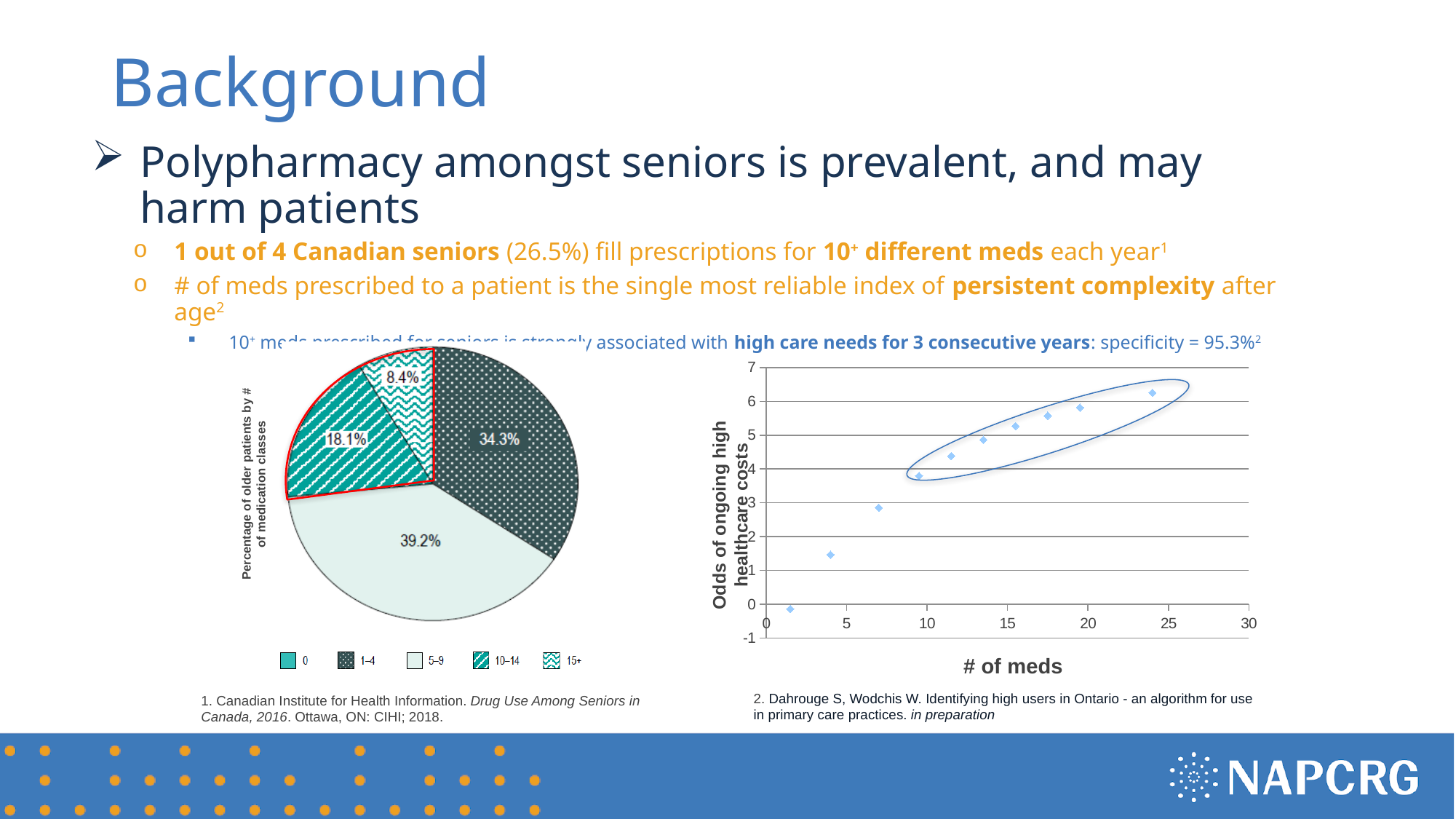
On the pie chart on the left, what is the difference in percentage points between the 5–9 and 1–4 categories? 4.9 percentage points On the scatter chart on the right, is the odds value for the point at about 4 meds greater or less than 2? less On the pie chart on the left, what percentage of older patients take 1–4 medication classes? 34.3% What kind of chart is shown on the right side of the slide? Scatter chart On the pie chart on the left, what is the combined share of the 10–14 and 15+ categories? 26.5% On the scatter chart on the right, do the odds of ongoing high healthcare costs rise or fall as the number of meds increases? Rise On the pie chart on the left, how many categories does the legend list? 5 On the pie chart on the left, which medication-class category has the largest share? 5–9 On the pie chart on the left, what percentage of older patients take 5–9 medication classes? 39.2% On the pie chart on the left, what percentage of older patients take 10–14 medication classes? 18.1% On the scatter chart on the right, what is the title of the x axis? # of meds On the pie chart on the left, what percentage of older patients take 15+ medication classes? 8.4%